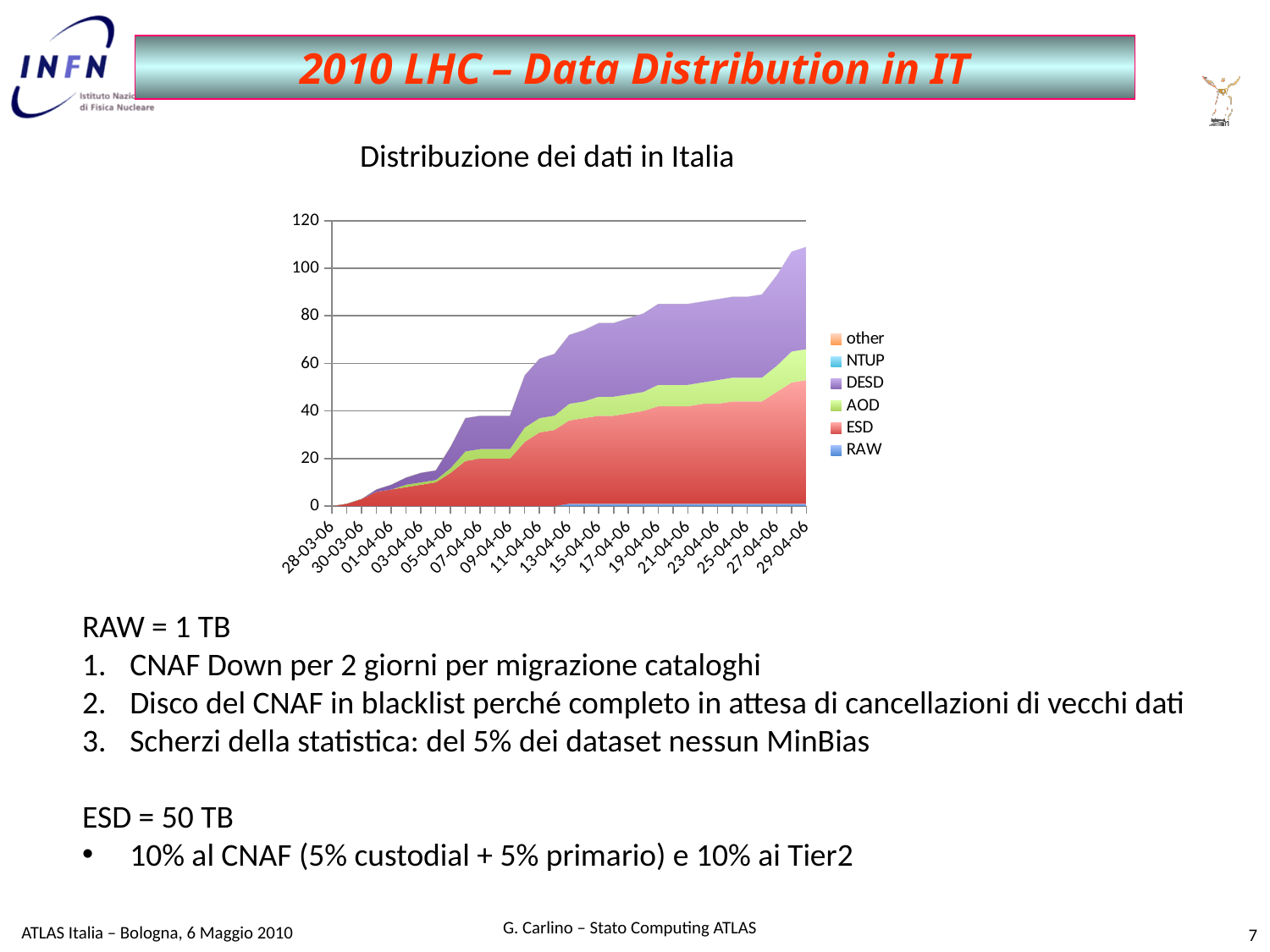
Is the stacked total on 09-04-06 greater or less than 60? less Is the stacked total on 15-04-06 greater or less than 60? greater On which date does the stacked total reach its highest value? 29-04-06 What kind of chart is shown on the slide? stacked area chart Do the stacked totals rise or fall from 28-03-06 to 29-04-06? rise How many series does the chart legend list? 6 Which series are listed in the chart legend? other, NTUP, DESD, AOD, ESD, RAW Is the stacked total on 29-04-06 greater or less than 100? greater How many date labels are shown on the x axis? 17 What is the title of the chart? Distribuzione dei dati in Italia What is the highest value shown on the y axis? 120